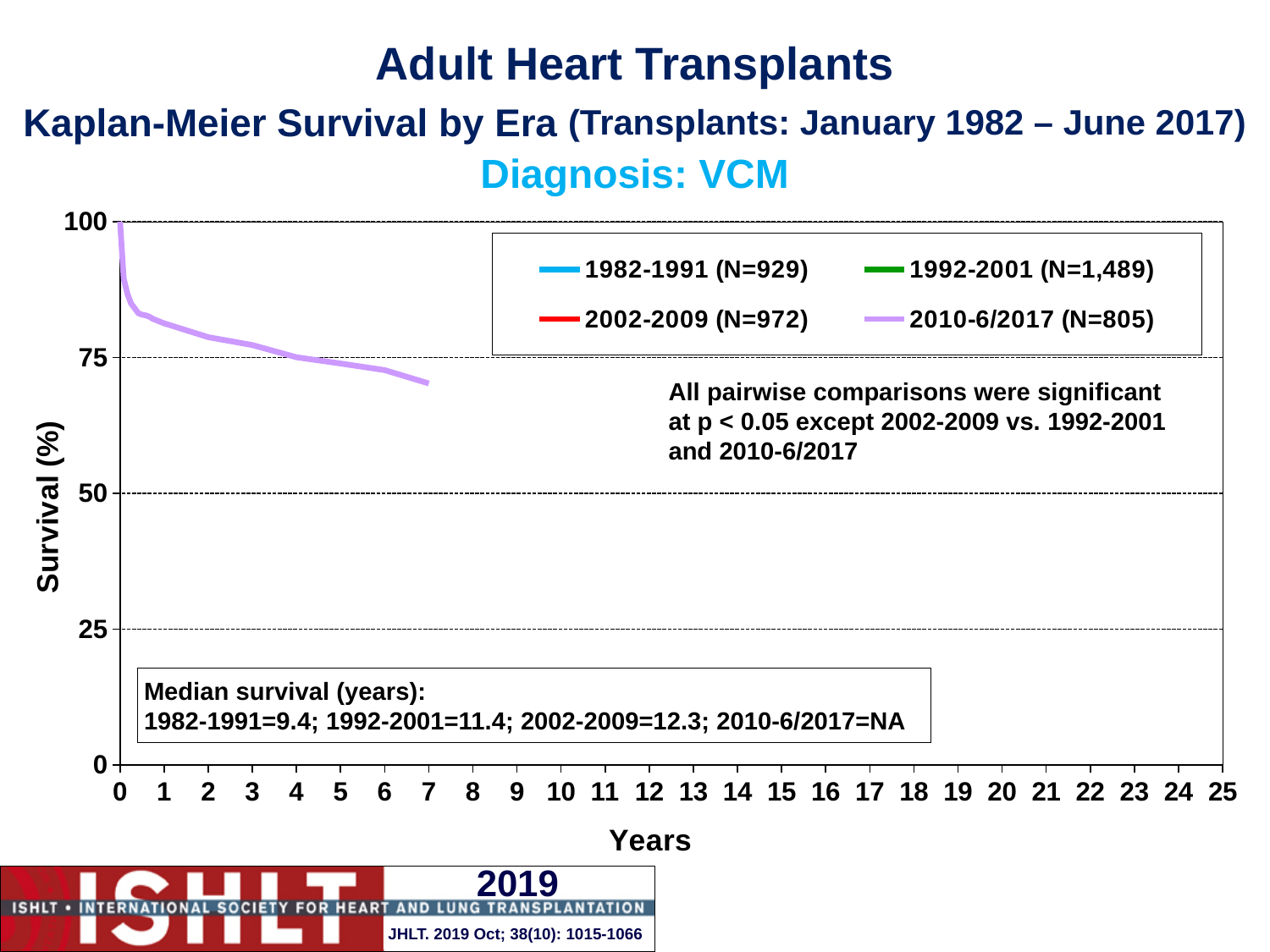
What kind of chart is shown on the slide? line chart What is the label of the y axis? Survival (%) Is the survival value for 2010-6/2017 at year 7 greater or less than 50? greater How many series does the legend list? 4 Is the survival value for 2010-6/2017 at year 1 greater or less than 75? greater What is the survival value for 2010-6/2017 at year 0? 100 What is the N shown in the legend for the 1992-2001 era? 1,489 What is the median survival in years for the 1982-1991 era according to the text box? 9.4 Does the plotted survival curve for 2010-6/2017 rise or fall as years increase? fall What is the median survival for the 2010-6/2017 era according to the text box? NA Is the survival value for 2010-6/2017 at year 7 greater or less than 75? less What is the median survival in years for the 2002-2009 era according to the text box? 12.3